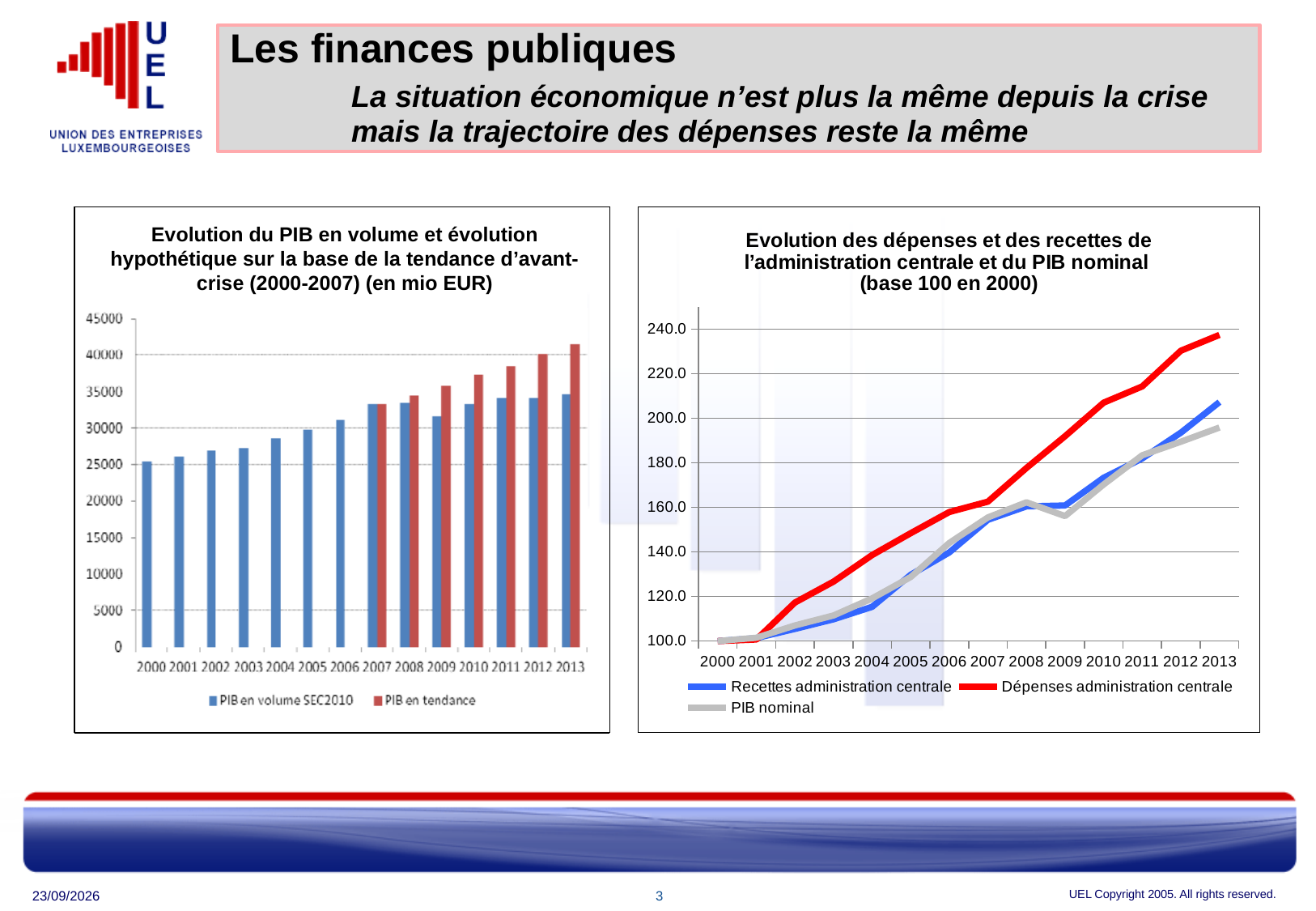
In the left chart, is the value of PIB en volume SEC2010 for 2000 greater or less than 30000? less What kind of chart is the right chart, 'Evolution des dépenses et des recettes de l'administration centrale et du PIB nominal'? Line chart In the right chart, what colour is the line for Dépenses administration centrale? Red In the right chart, is the value for Dépenses administration centrale in 2013 greater or less than 220.0? greater In the right chart, how many series does the legend list? 3 In the left chart, how many years are shown on the x axis? 14 In the right chart, which series has the highest value in 2013? Dépenses administration centrale In the right chart, do the values for Dépenses administration centrale rise or fall from 2000 to 2013? Rise In the left chart, which series has the larger value in 2013, PIB en volume SEC2010 or PIB en tendance? PIB en tendance In the left chart, how many series does the legend list? 2 In the left chart, is the value of PIB en tendance for 2013 greater or less than 40000? greater What kind of chart is the left chart, 'Evolution du PIB en volume et évolution hypothétique sur la base de la tendance d'avant-crise'? Bar chart